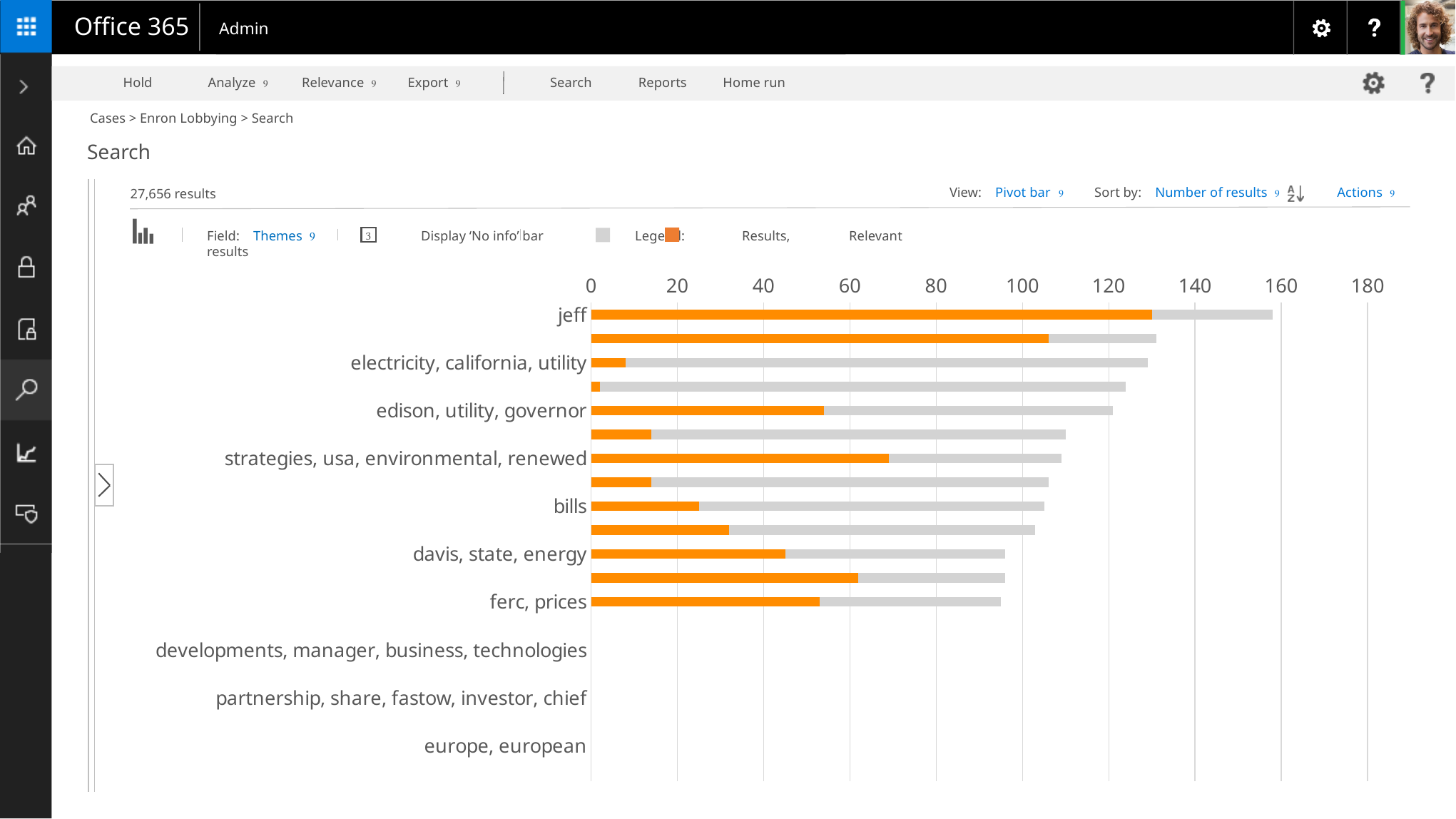
Which colour represents the Relevant series in the chart? orange How many series does the chart legend list? 2 Is the Relevant value for 'edison, utility, governor' greater or less than 40? greater Is the Relevant value for 'electricity, california, utility' greater or less than 20? less Which theme has the longest Results bar? jeff Is the Results value for 'ferc, prices' greater or less than 100? less Which has the larger Results value, jeff or 'ferc, prices'? jeff What kind of chart is shown on the slide? bar chart What are the two series named in the chart legend? Results, Relevant